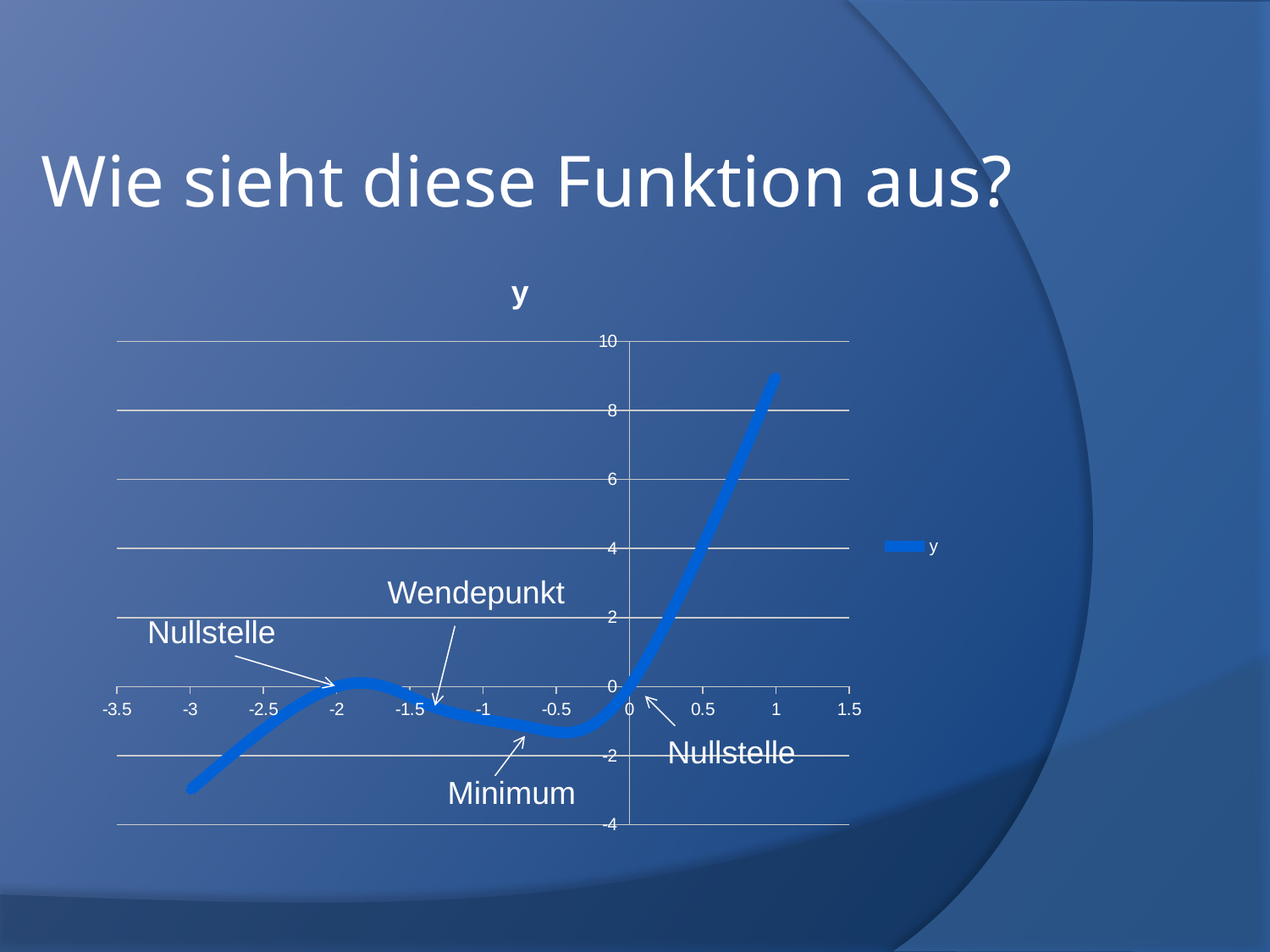
What is the lowest value shown on the y axis? -4 What kind of chart is shown on the slide? line chart Which is larger, the value of y at x = 1 or at x = -3? x = 1 Is the value of y at x = -3 greater or less than -2? less What is the title of the chart? y Is the value of y at x = 0.5 greater or less than 2? greater Is the value of y at x = 1 greater or less than 8? greater Does the curve rise or fall between x = -2 and x = -0.5? fall Does the curve rise or fall between x = 0 and x = 1? rise How many series does the legend list? 1 What is the value of y at x = 0? 0